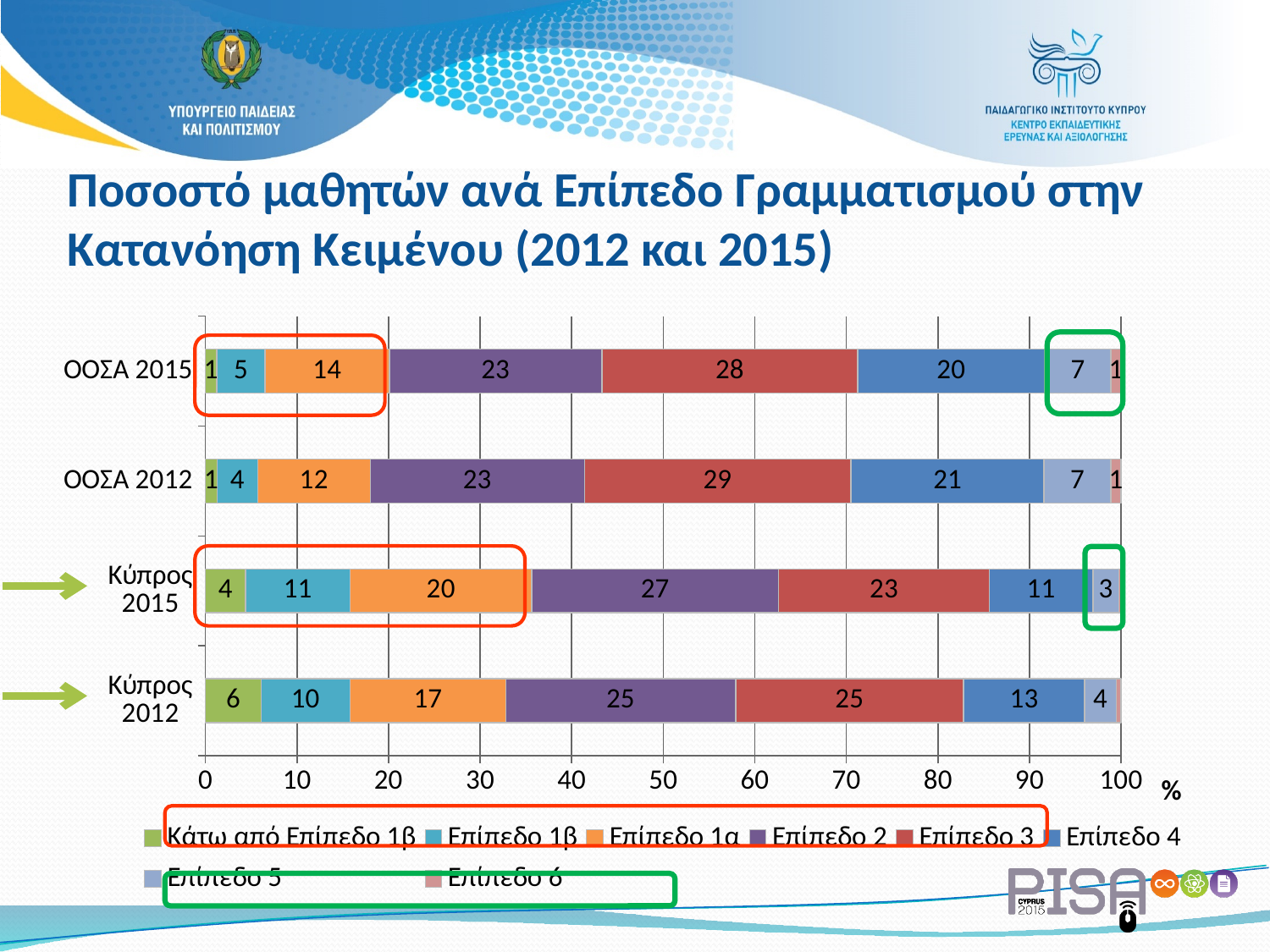
How many series does the legend list? 8 What is the difference between the Επίπεδο 1β values for Κύπρος 2015 and ΟΟΣΑ 2015? 6 What is the value of Επίπεδο 1α for Κύπρος 2015? 20 What is the value of Κάτω από Επίπεδο 1β for Κύπρος 2012? 6 Which category has the highest value for Επίπεδο 2? Κύπρος 2015 What unit is shown at the end of the x axis? % How many categories (bars) does the chart show? 4 What is the value of Επίπεδο 4 for ΟΟΣΑ 2012? 21 Which category has the lowest value for Επίπεδο 4? Κύπρος 2015 Which is larger: Επίπεδο 5 for ΟΟΣΑ 2015 or Επίπεδο 5 for Κύπρος 2015? ΟΟΣΑ 2015 What type of chart is shown on the slide? stacked bar chart What is the value of Επίπεδο 3 for ΟΟΣΑ 2015? 28